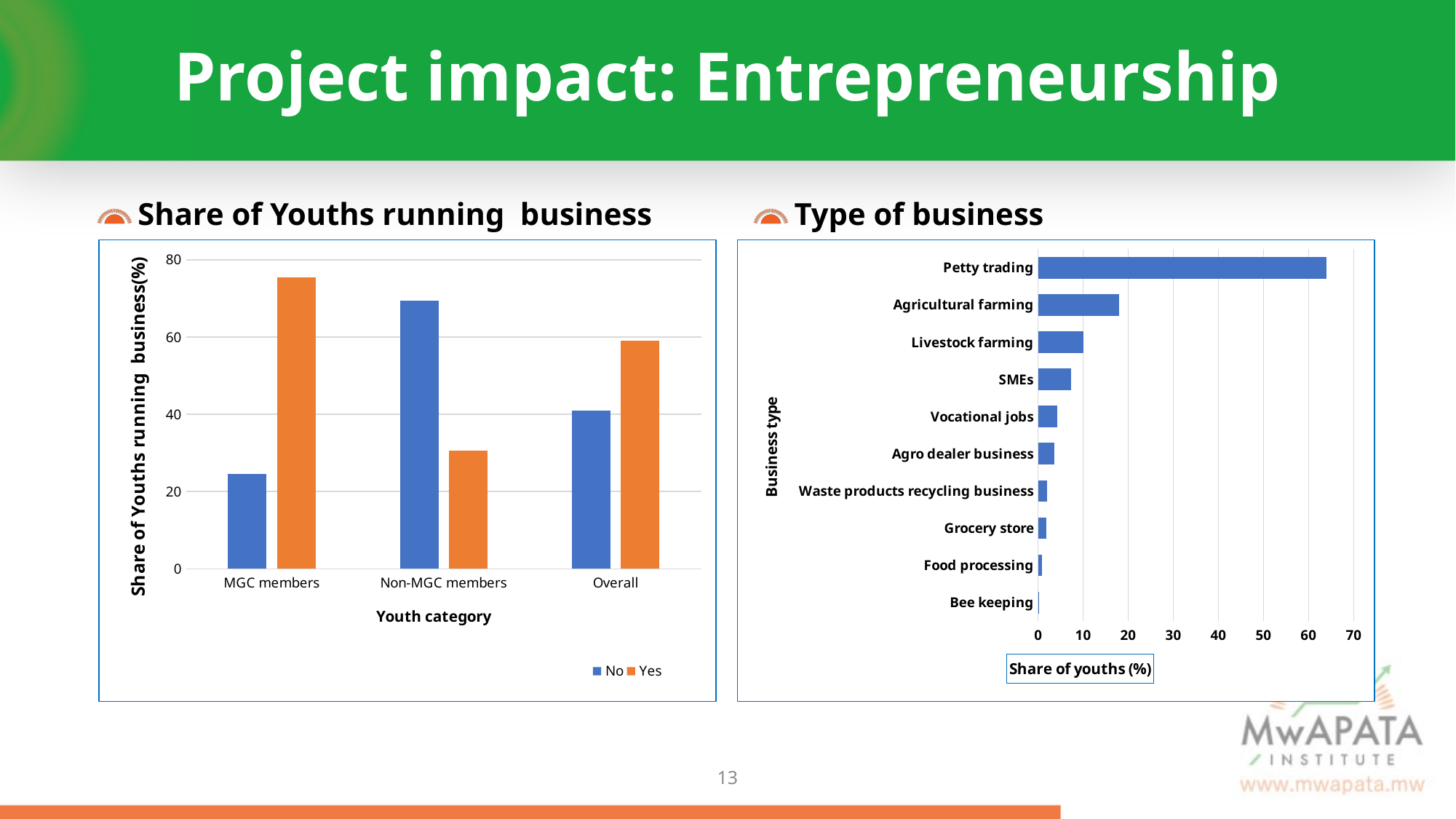
In the 'Share of Youths running business' chart, which is larger for Non-MGC members, 'No' or 'Yes'? No In the 'Share of Youths running business' chart, is the 'No' value for MGC members greater or less than 40? less In the 'Type of business' chart, how many business types are listed? 10 In the 'Type of business' chart, which business type has the lowest share of youths? Bee keeping In the 'Share of Youths running business' chart, which youth category has the highest 'Yes' value? MGC members In the 'Share of Youths running business' chart, what is the label of the x axis? Youth category In the 'Type of business' chart, is the value for Petty trading greater or less than 60? greater In the 'Share of Youths running business' chart, what kind of chart is shown? bar chart In the 'Share of Youths running business' chart, how many series does the legend list? 2 In the 'Type of business' chart, which business type has the highest share of youths? Petty trading In the 'Share of Youths running business' chart, is the 'Yes' value for MGC members greater or less than 60? greater In the 'Share of Youths running business' chart, how many youth categories are shown on the x axis? 3